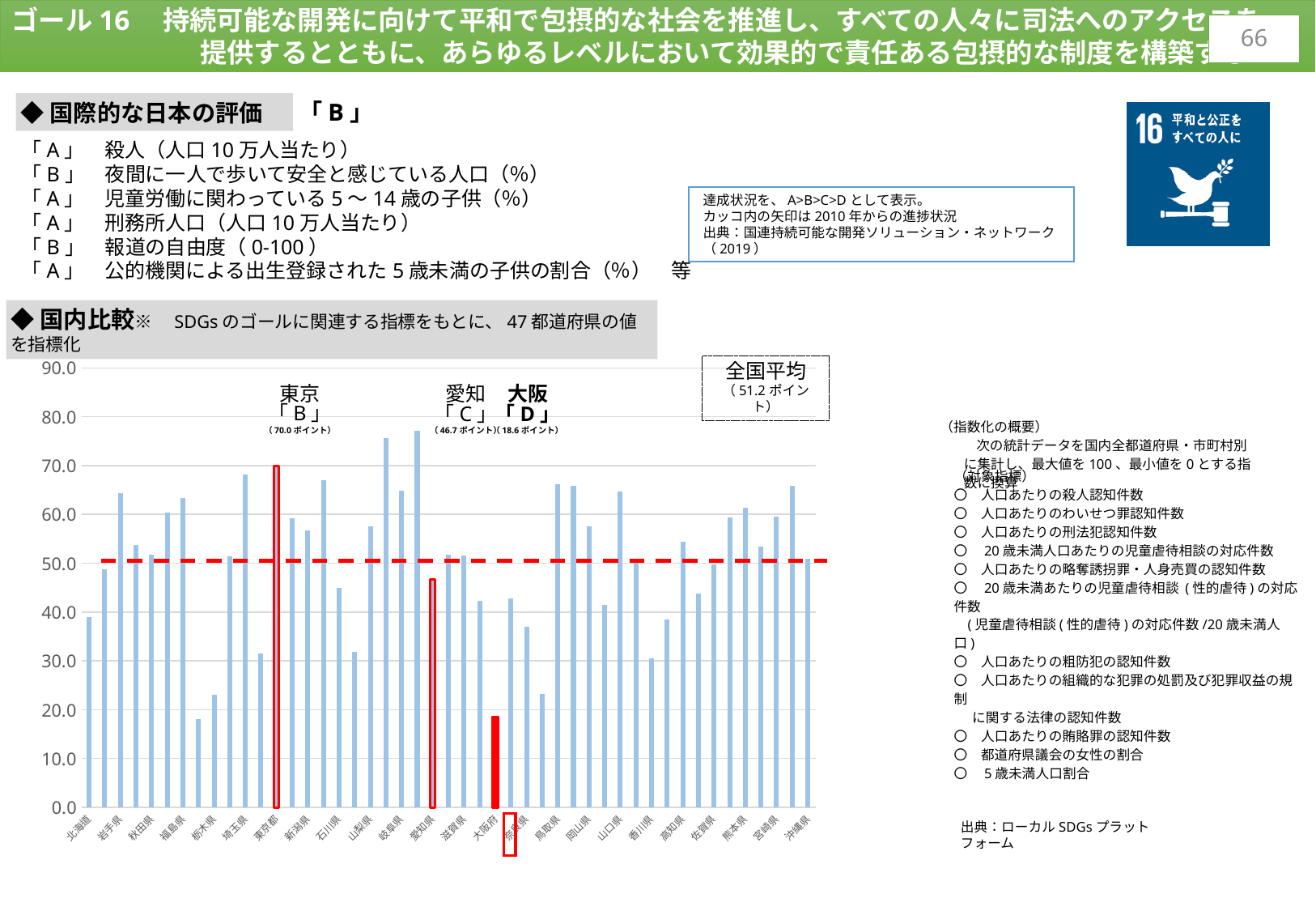
Is the value for 北海道 greater or less than 50? less What is the value for 愛知 in the 国内比較 bar chart? 46.7 ポイント What is the 全国平均 value shown on the chart? 51.2 ポイント What is the difference between the values for 東京 and 大阪? 51.4 ポイント What does the red dashed horizontal line on the chart represent? 全国平均 What is the value for 大阪 in the 国内比較 bar chart? 18.6 ポイント What is the difference between the values for 東京 and 愛知? 23.3 ポイント Is the value for 埼玉県 greater or less than 60? greater What kind of chart is used for the 国内比較? bar chart What is the value for 東京 in the 国内比較 bar chart? 70.0 ポイント Is the value for 栃木県 greater or less than 30? less Which has the larger value, 愛知 or 大阪? 愛知